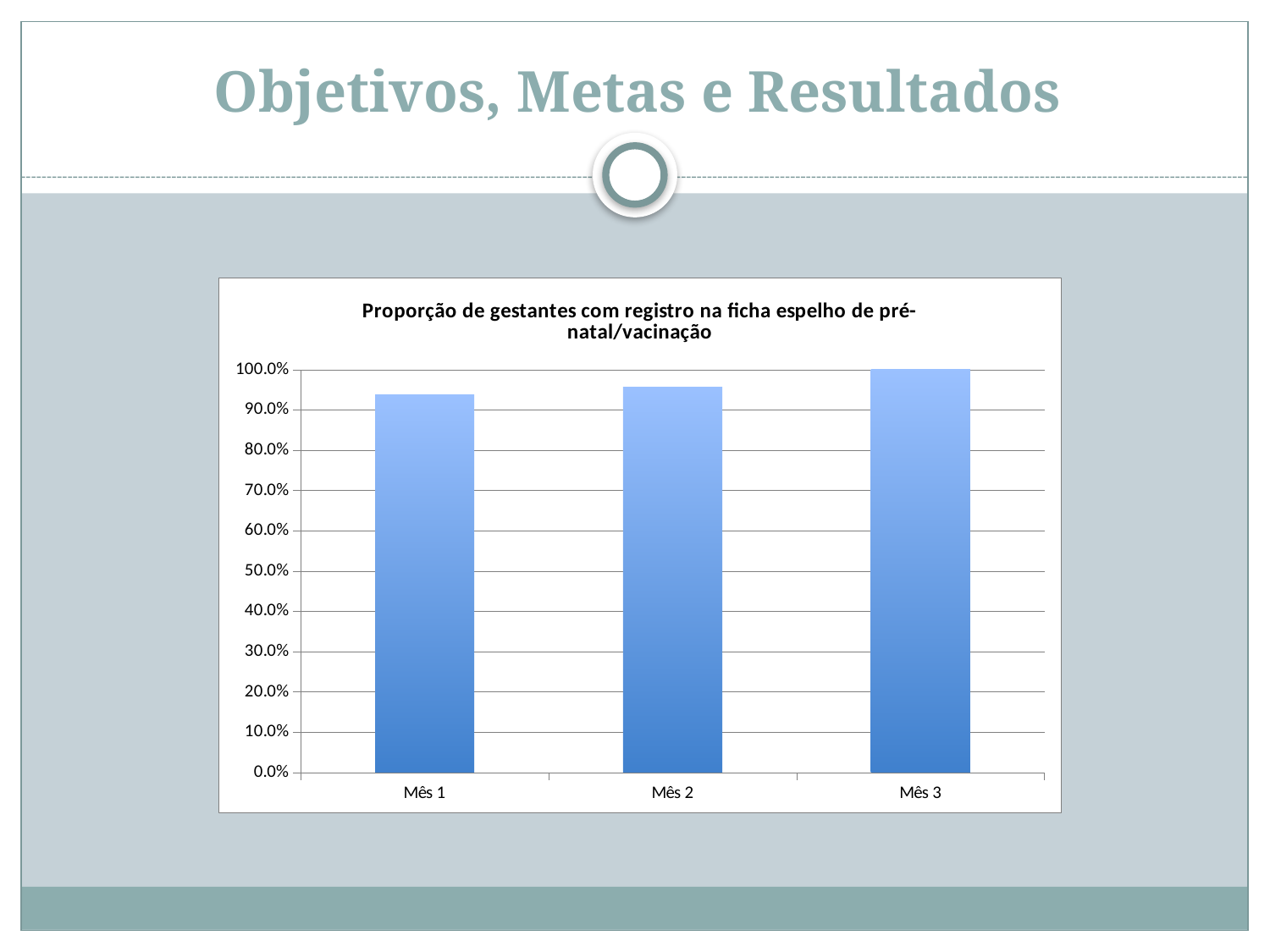
What is the label of the first category on the x axis? Mês 1 Is the value for Mês 1 greater or less than 90.0%? greater Which is larger, the value for Mês 2 or the value for Mês 1? Mês 2 Do the values rise or fall from Mês 1 to Mês 3? rise What kind of chart is shown on the slide? bar chart What is the value for Mês 3? 100.0% Is the value for Mês 2 greater or less than 100.0%? less How many categories (months) are plotted on the chart? 3 Is the value for Mês 1 greater or less than 100.0%? less What is the title of the chart? Proporção de gestantes com registro na ficha espelho de pré-natal/vacinação Which month has the highest proportion? Mês 3 Which month has the lowest proportion? Mês 1